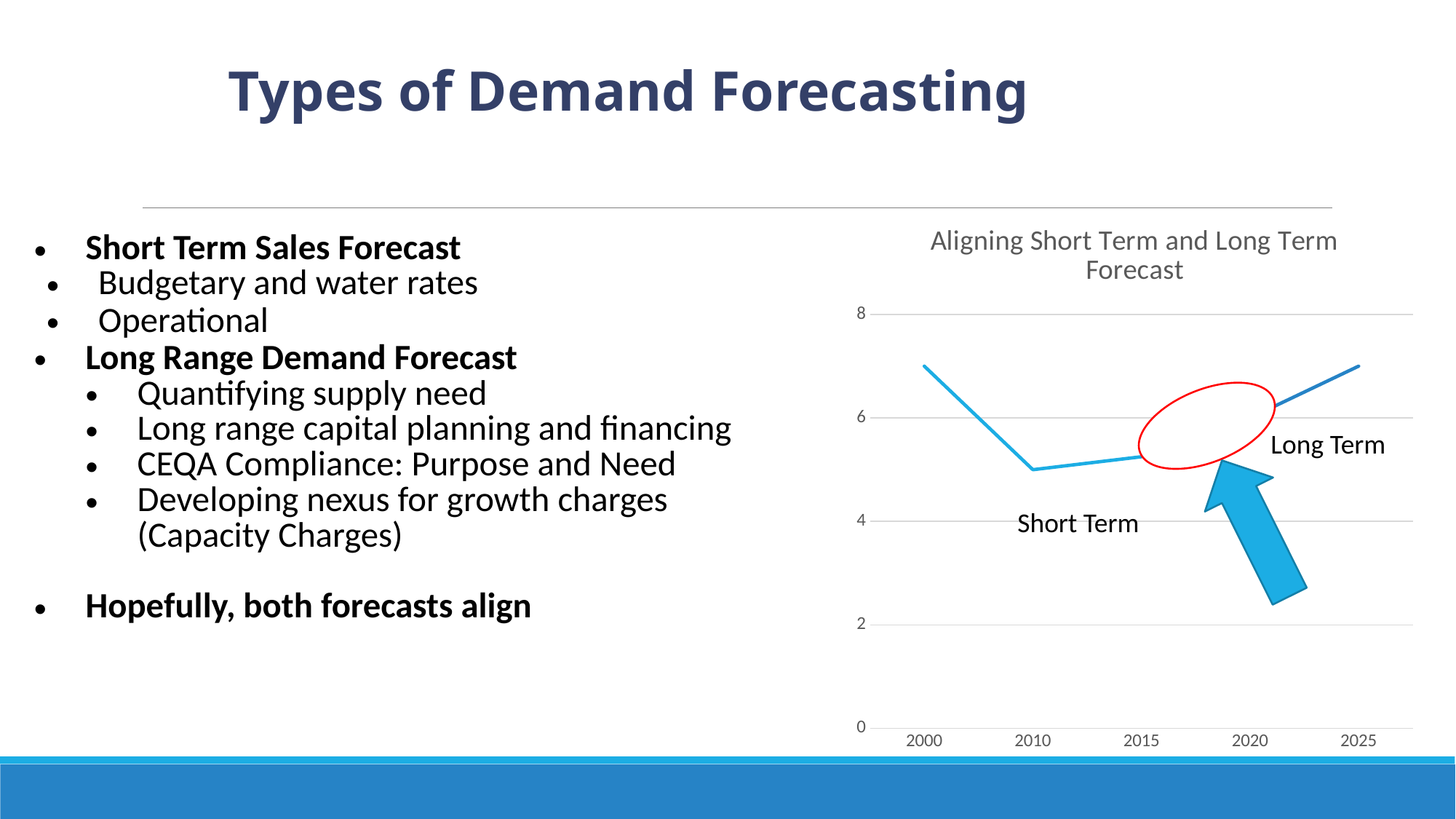
Does the Long Term line rise or fall from 2020 to 2025? rise Is the value for 2010 greater or less than 6? less Does the Short Term line rise or fall from 2000 to 2010? fall How many years are labelled on the x axis of the chart? 5 Is the value for 2025 greater or less than 6? greater Is the value for 2010 greater or less than 4? greater Which is larger, the value for 2000 or the value for 2010? 2000 Which year has the lowest plotted value on the chart? 2010 Which two line labels appear on the chart? Short Term and Long Term What kind of chart is shown on the slide? line chart What is the title of the chart? Aligning Short Term and Long Term Forecast